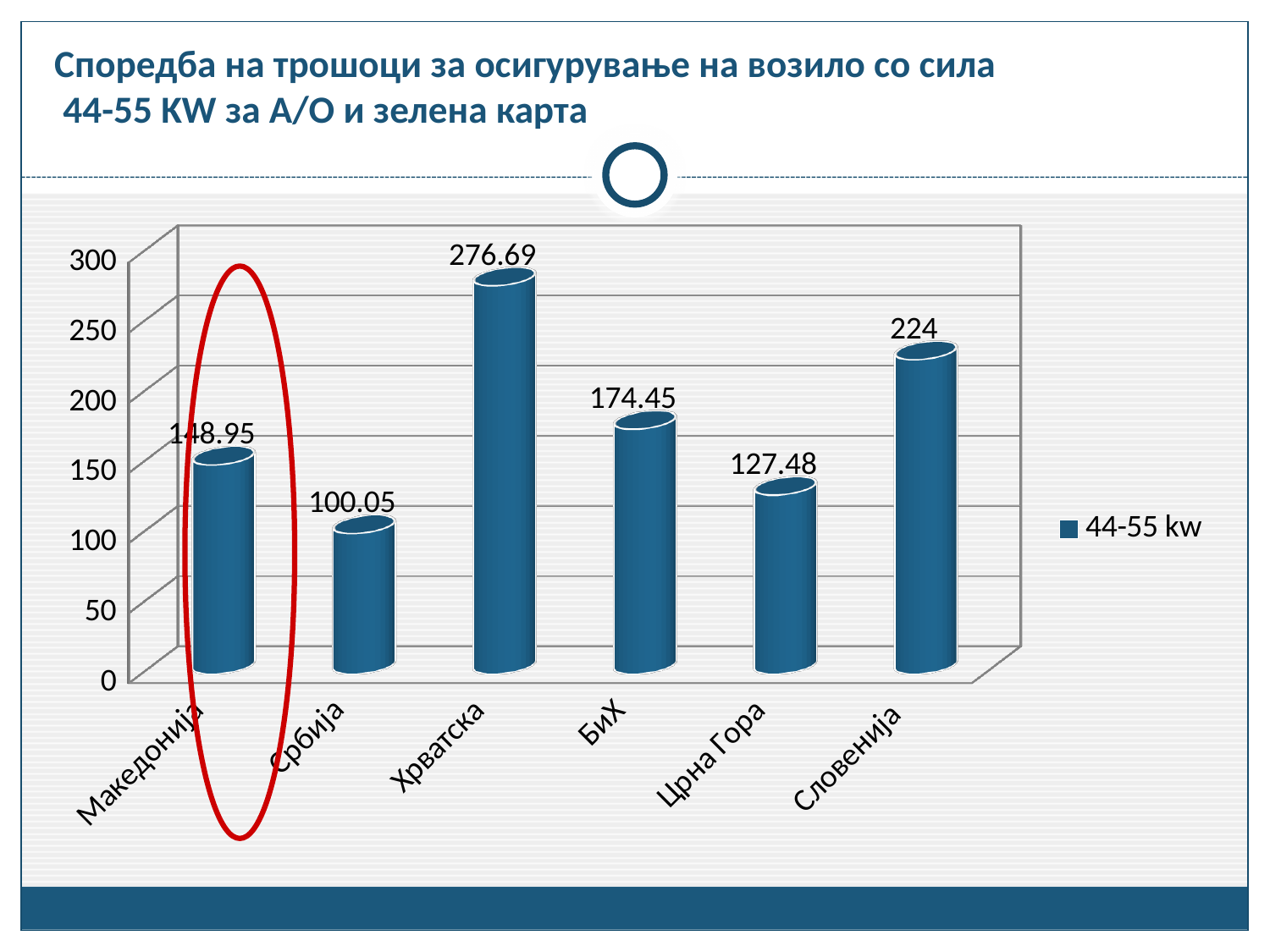
Which country has the highest value? Хрватска What is the value for Хрватска? 276.69 What series name does the legend show? 44-55 kw What is the difference between the values for Хрватска and Македонија? 127.74 How many countries are shown on the chart? 6 What kind of chart is shown on the slide? bar chart What is the value for Словенија? 224 What is the value for Македонија? 148.95 Is the value for Србија greater or less than 150? less Which is larger, the value for БиХ or the value for Словенија? Словенија Which country has the lowest value? Србија What is the value for Црна Гора? 127.48